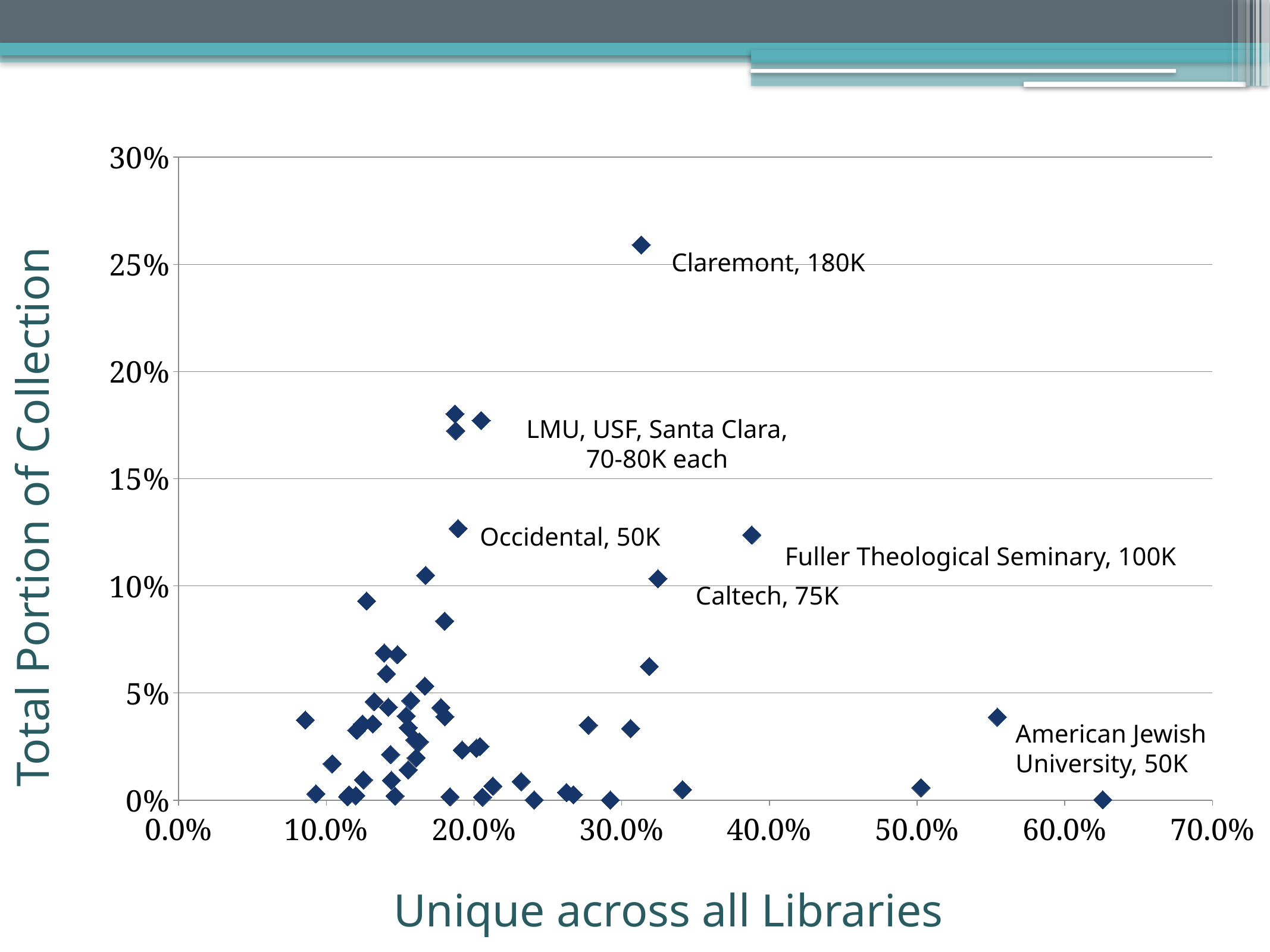
What is the label of the horizontal axis? Unique across all Libraries Which labelled library has the highest value on the Unique across all Libraries axis? American Jewish University Which has a higher Unique across all Libraries value, Fuller Theological Seminary or Occidental? Fuller Theological Seminary Is the Total Portion of Collection for Occidental greater or less than 15%? less Is the Unique across all Libraries value for Fuller Theological Seminary greater or less than 40.0%? less Is the Unique across all Libraries value for American Jewish University greater or less than 50.0%? greater What kind of chart is shown on the slide? scatter chart Which labelled library has the highest Total Portion of Collection? Claremont What is the label of the vertical axis? Total Portion of Collection Which has a higher Total Portion of Collection, Claremont or Occidental? Claremont